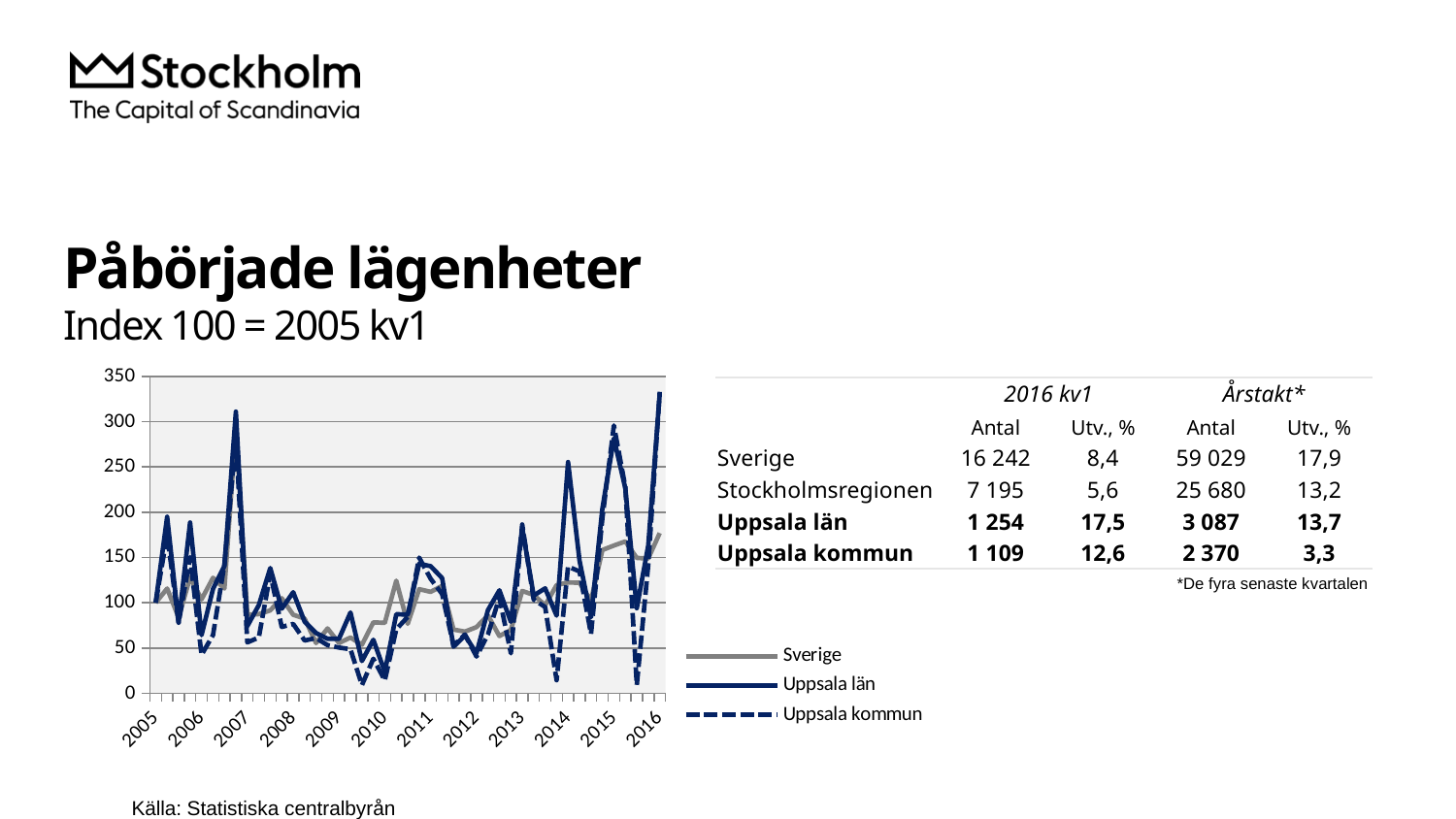
Is the lowest value for Uppsala kommun around 2009–2010 greater or less than 50? less Is the peak value of Uppsala län in 2007 greater or less than 300? greater How many series does the chart legend list? 3 What is the highest value shown on the chart's vertical axis? 350 Which series are listed in the chart legend? Sverige, Uppsala län, Uppsala kommun What type of chart is shown on the slide? Line chart Which years are shown at the start and end of the chart's horizontal axis? 2005 and 2016 Does the Sverige series rise or fall overall from 2009 to 2016? Rises What is the index value of all series at 2005 kv1, the base period of the chart? 100 Is the value for Sverige at the end of the chart in 2016 greater or less than 200? less Which series is drawn as a dashed line in the chart? Uppsala kommun